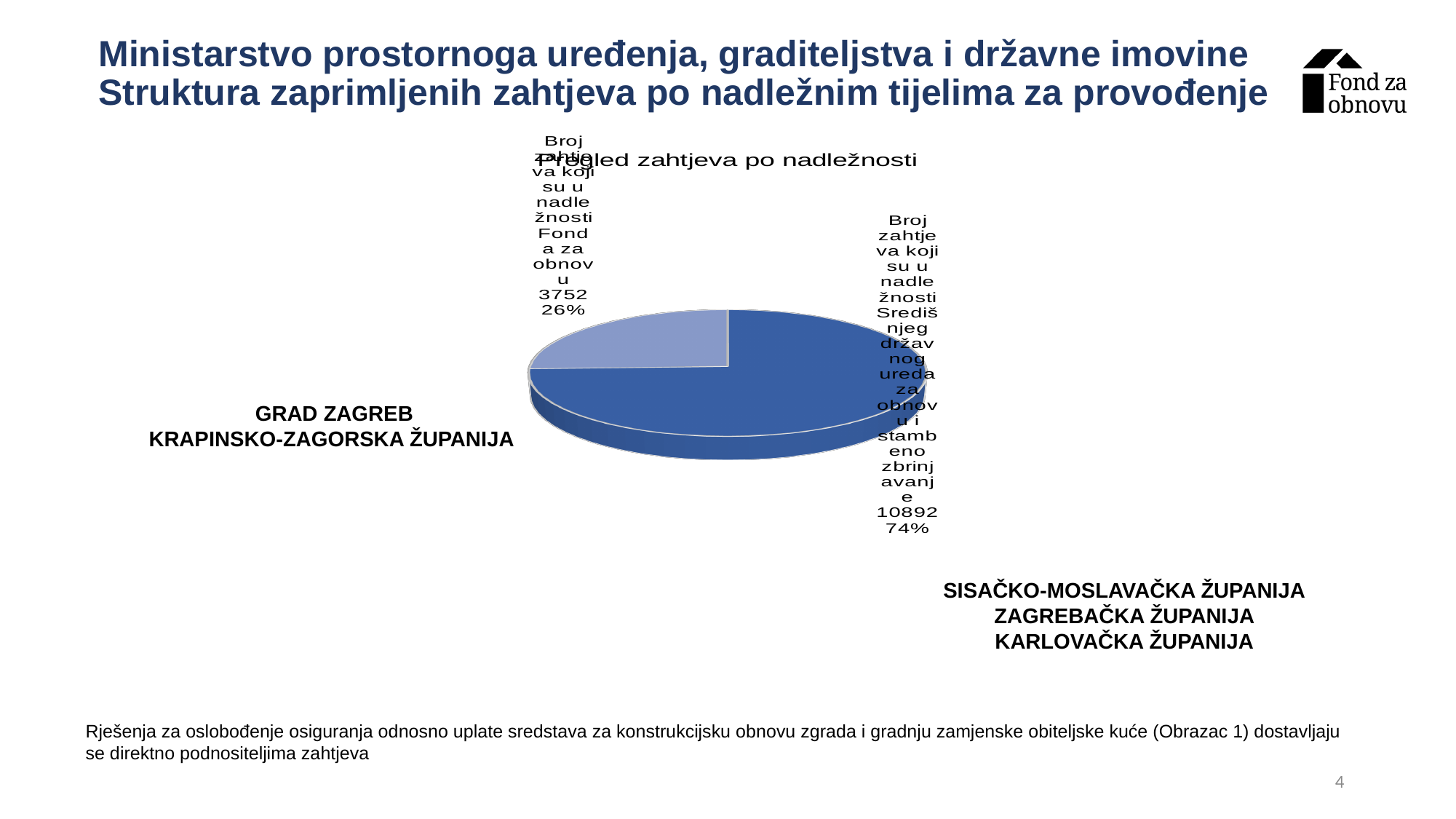
What is the title of the chart? Pregled zahtjeva po nadležnosti Which has more requests: Fond za obnovu or Središnji državni ured za obnovu i stambeno zbrinjavanje? Središnji državni ured za obnovu i stambeno zbrinjavanje Which slice is the largest in the pie chart? Broj zahtjeva koji su u nadležnosti Središnjeg državnog ureda za obnovu i stambeno zbrinjavanje What share of the pie is the slice for Središnji državni ured za obnovu i stambeno zbrinjavanje? 74% How many slices does the pie chart have? 2 What share of the pie is the slice for Fond za obnovu? 26% What is the difference between the number of requests for Središnji državni ured (10892) and for Fond za obnovu (3752)? 7140 What is the total number of requests across both slices of the pie chart? 14644 What kind of chart is shown on the slide? pie chart Which slice is the smallest in the pie chart? Broj zahtjeva koji su u nadležnosti Fonda za obnovu How many requests are in the competence of Fond za obnovu (Broj zahtjeva koji su u nadležnosti Fonda za obnovu)? 3752 How many requests are in the competence of Središnji državni ured za obnovu i stambeno zbrinjavanje? 10892